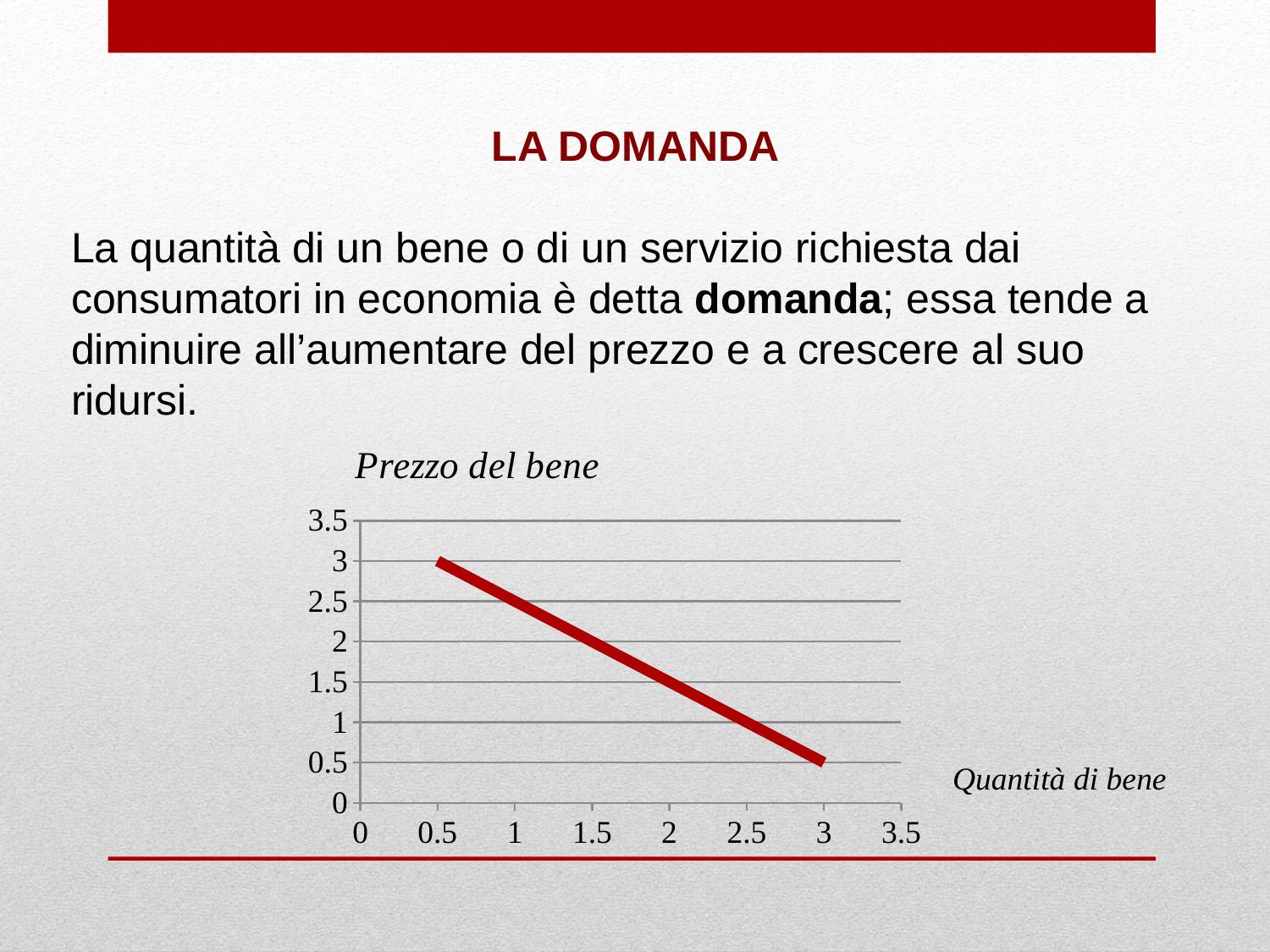
Is the price at quantity 1 greater or less than 2? greater What is the price (y value) where the line ends, at quantity 3? 0.5 What kind of chart is shown on the slide? line chart Is the price at quantity 1.5 greater or less than 2.5? less What is the label of the horizontal axis of the chart? Quantità di bene Which is larger, the price at quantity 0.5 or the price at quantity 3? the price at quantity 0.5 What is the price (y value) where the line starts, at quantity 0.5? 3 Does the line rise or fall as the quantity (x axis) increases? fall At which quantity does the line reach its highest price? 0.5 At which quantity does the line reach its lowest price? 3 What is the label of the vertical axis of the chart? Prezzo del bene Is the price at quantity 2.5 greater or less than 1.5? less